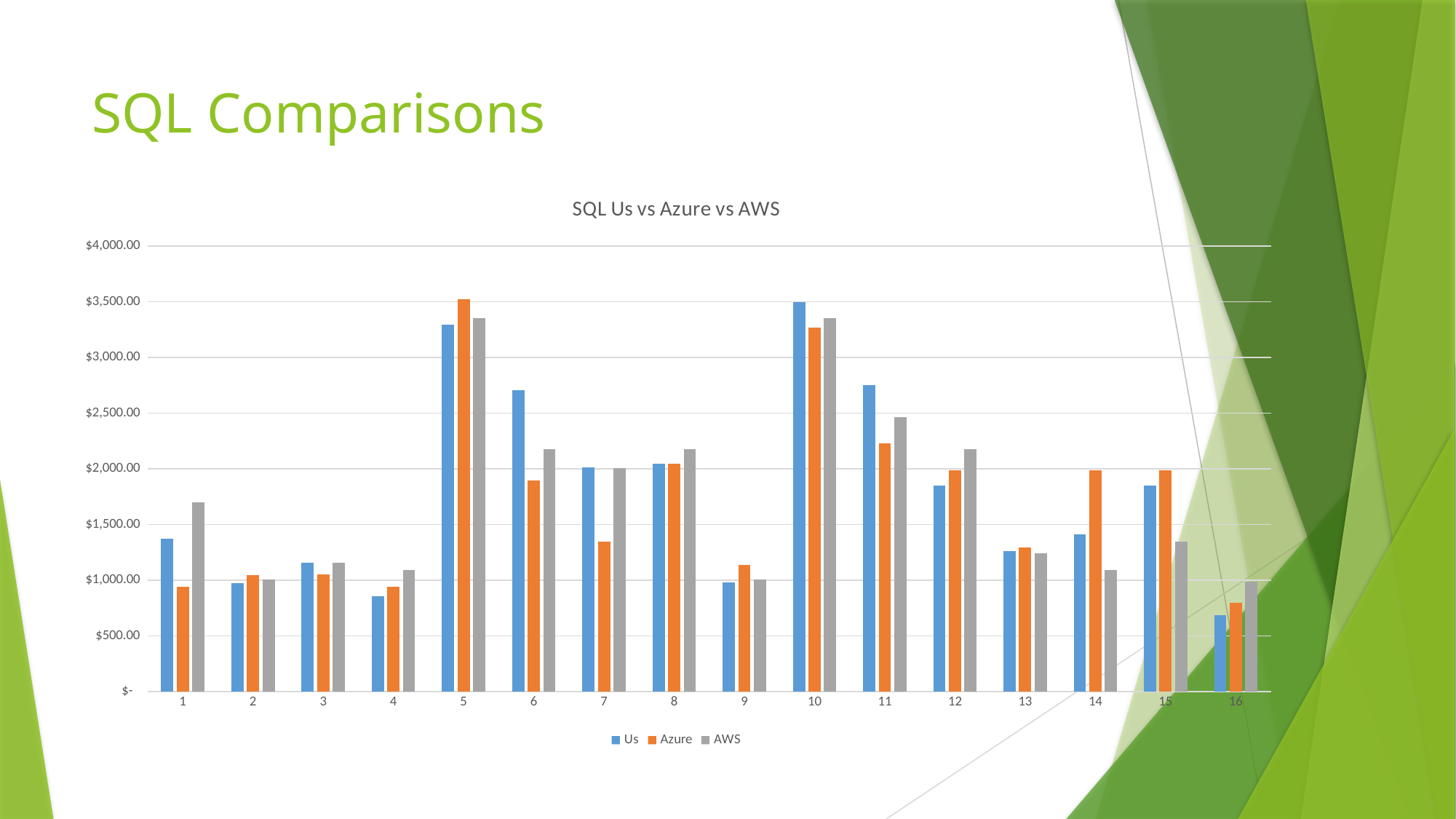
How many series does the legend list? 3 For category 14, which is larger: the Azure value or the AWS value? Azure What is the title of the chart? SQL Us vs Azure vs AWS For which category is the Azure value highest? 5 Is the AWS value for category 1 greater or less than $1,500.00? greater How many categories are shown along the x axis? 16 Is the Azure value for category 7 greater or less than $1,500.00? less For which category is the Us value lowest? 16 Is the Us value for category 6 greater or less than $2,500.00? greater For which category is the Us value highest? 10 Which colour represents the Azure series in the legend? orange What kind of chart is shown on the slide? bar chart